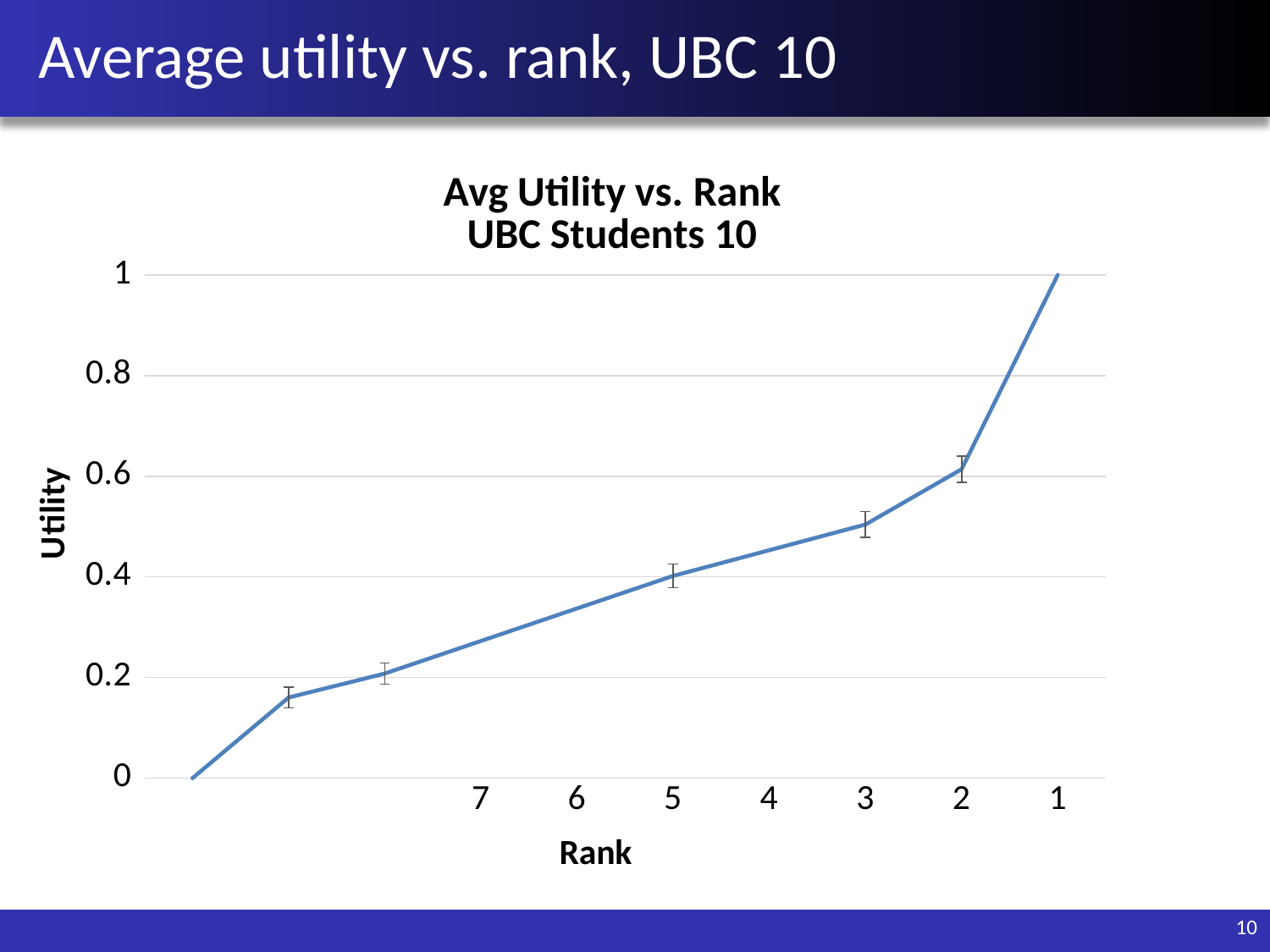
Is the utility value at rank 3 greater or less than 0.6? less Is the utility value at rank 2 greater or less than 0.4? greater Does the utility rise or fall as the line moves from left to right along the x axis? rise What is the title of the y axis? Utility Is the utility value at rank 2 greater or less than 0.8? less What is the utility value at rank 1? 1 Which has a higher utility value, rank 3 or rank 5? rank 3 Which has a higher utility value, rank 1 or rank 2? rank 1 What kind of chart is shown on the slide? line chart Which rank has the highest utility value? 1